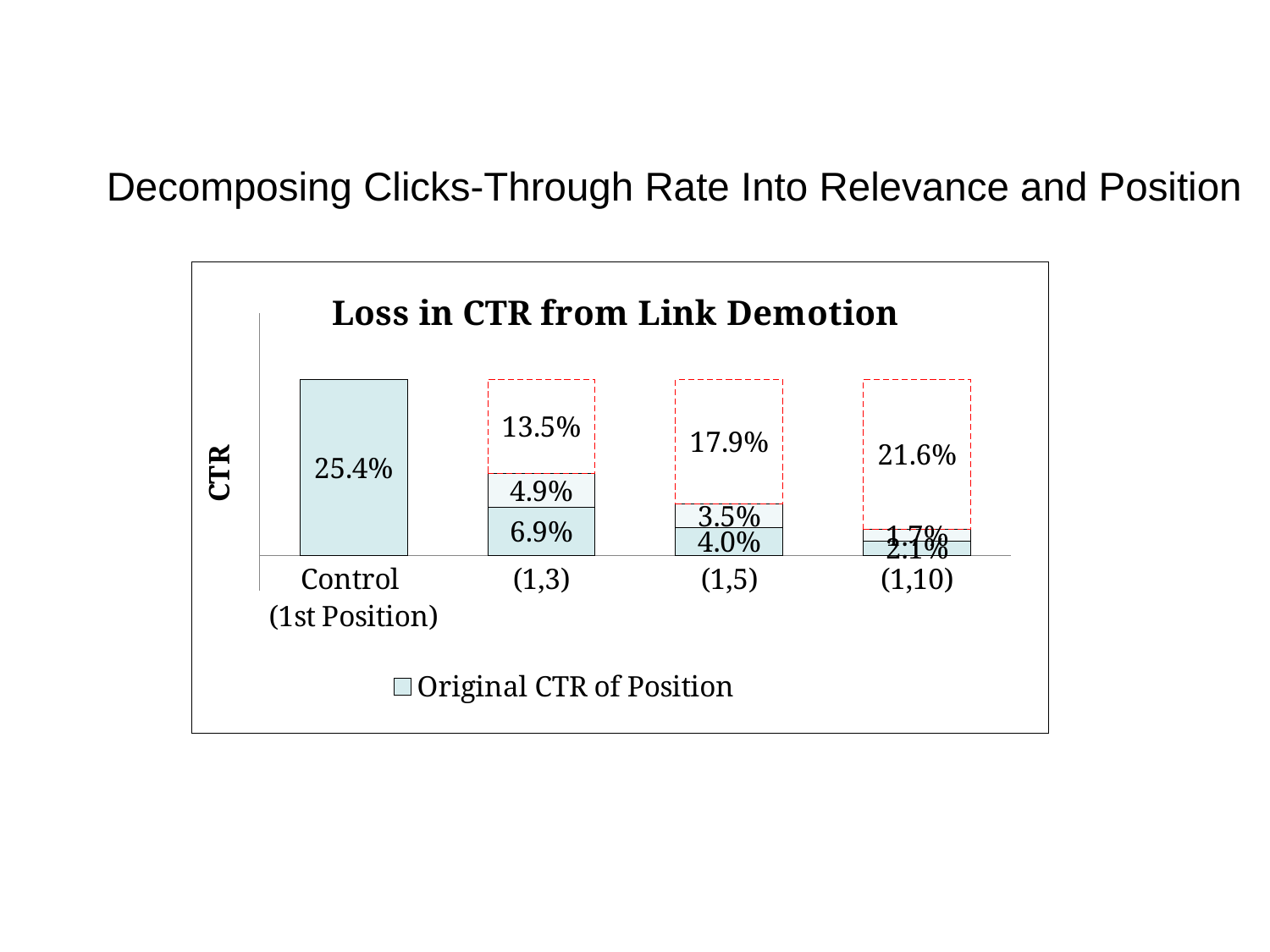
Which category has the smallest Original CTR of Position (bottom segment)? (1,10) What is the value of the middle segment for the (1,5) bar? 3.5% What is the total of the three labelled segments in the (1,3) bar? 25.3% What is the value of the top dashed segment for the (1,10) bar? 21.6% How many categories are shown on the x axis? 4 Which has a larger top dashed segment, (1,3) or (1,5)? (1,5) What is the value of the bottom (Original CTR of Position) segment for the (1,3) bar? 6.9% Which category has the largest Original CTR of Position (bottom segment)? Control (1st Position) Does the Original CTR of Position (bottom segment) rise or fall from left to right across the categories? Fall What is the difference between the top dashed segment of (1,10) (21.6%) and that of (1,3) (13.5%)? 8.1 percentage points What kind of chart is shown on the slide? Stacked bar chart What is the CTR value shown for the Control (1st Position) bar? 25.4%